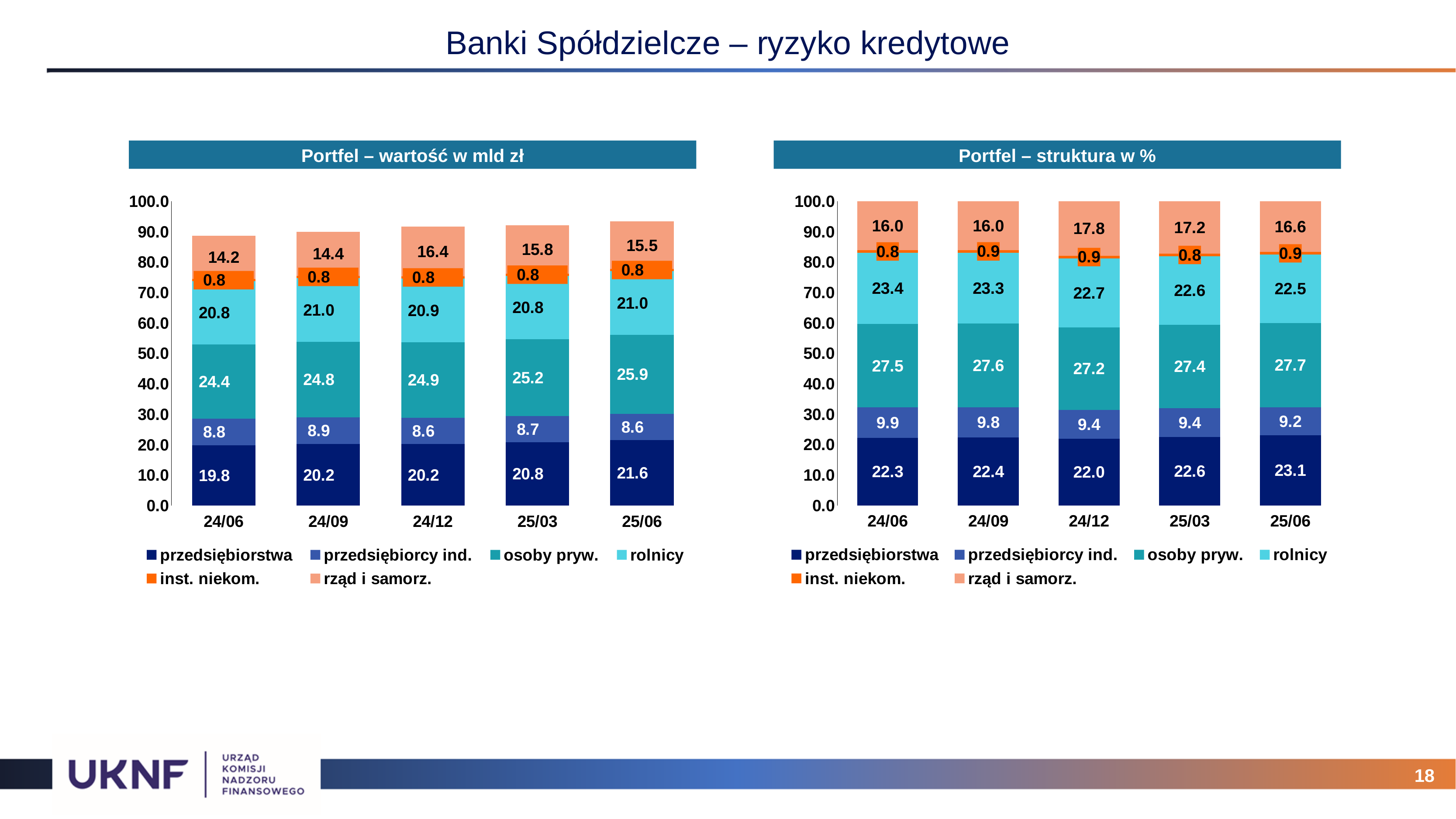
In the 'Portfel – wartość w mld zł' chart, what is the value for przedsiębiorstwa at 25/06? 21.6 In the 'Portfel – wartość w mld zł' chart, does the przedsiębiorstwa value rise or fall from 24/06 to 25/06? rise In the 'Portfel – wartość w mld zł' chart, what is the difference between the osoby pryw. values at 25/06 and 24/06? 1.5 In the 'Portfel – struktura w %' chart, what is the value for osoby pryw. at 24/12? 27.2 How many series does the legend of the 'Portfel – struktura w %' chart list? 6 How many periods are shown on the x axis of the 'Portfel – wartość w mld zł' chart? 5 In the 'Portfel – wartość w mld zł' chart, is the total height of the 25/06 bar greater or less than 90.0? greater In the 'Portfel – wartość w mld zł' chart, at which period is the rząd i samorz. value highest? 24/12 In the 'Portfel – wartość w mld zł' chart, what is the total of the stacked bar for 24/06? 88.8 In the 'Portfel – struktura w %' chart, at which period is the przedsiębiorstwa share lowest? 24/12 In the 'Portfel – struktura w %' chart, which is larger at 25/03: the rolnicy share or the przedsiębiorstwa share? Neither; both are 22.6 What kind of chart is the 'Portfel – wartość w mld zł' chart? stacked bar chart